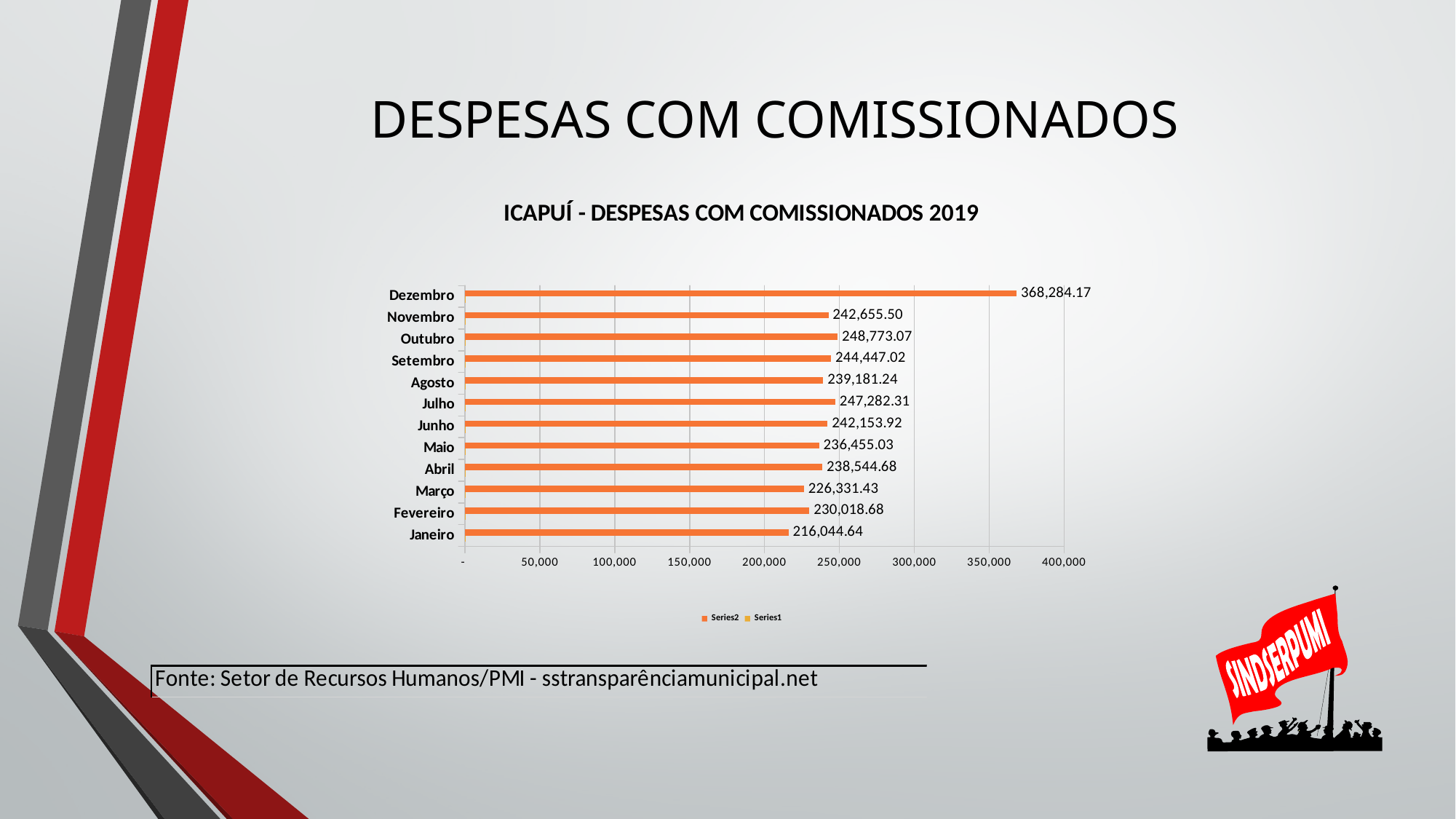
Which month has the lowest value? Janeiro What is the difference between the values for Dezembro and Janeiro? 152,239.53 How many series does the legend list? 2 How many months are shown in the chart? 12 Which is larger, the value for Julho or the value for Agosto? Julho What kind of chart is shown on the slide? bar chart What is the value for Julho? 247,282.31 What is the difference between the values for Outubro and Novembro? 6,117.57 Which month has the highest value? Dezembro What is the value for Janeiro? 216,044.64 Is the value for Dezembro greater or less than 350,000? greater What is the value for Dezembro? 368,284.17